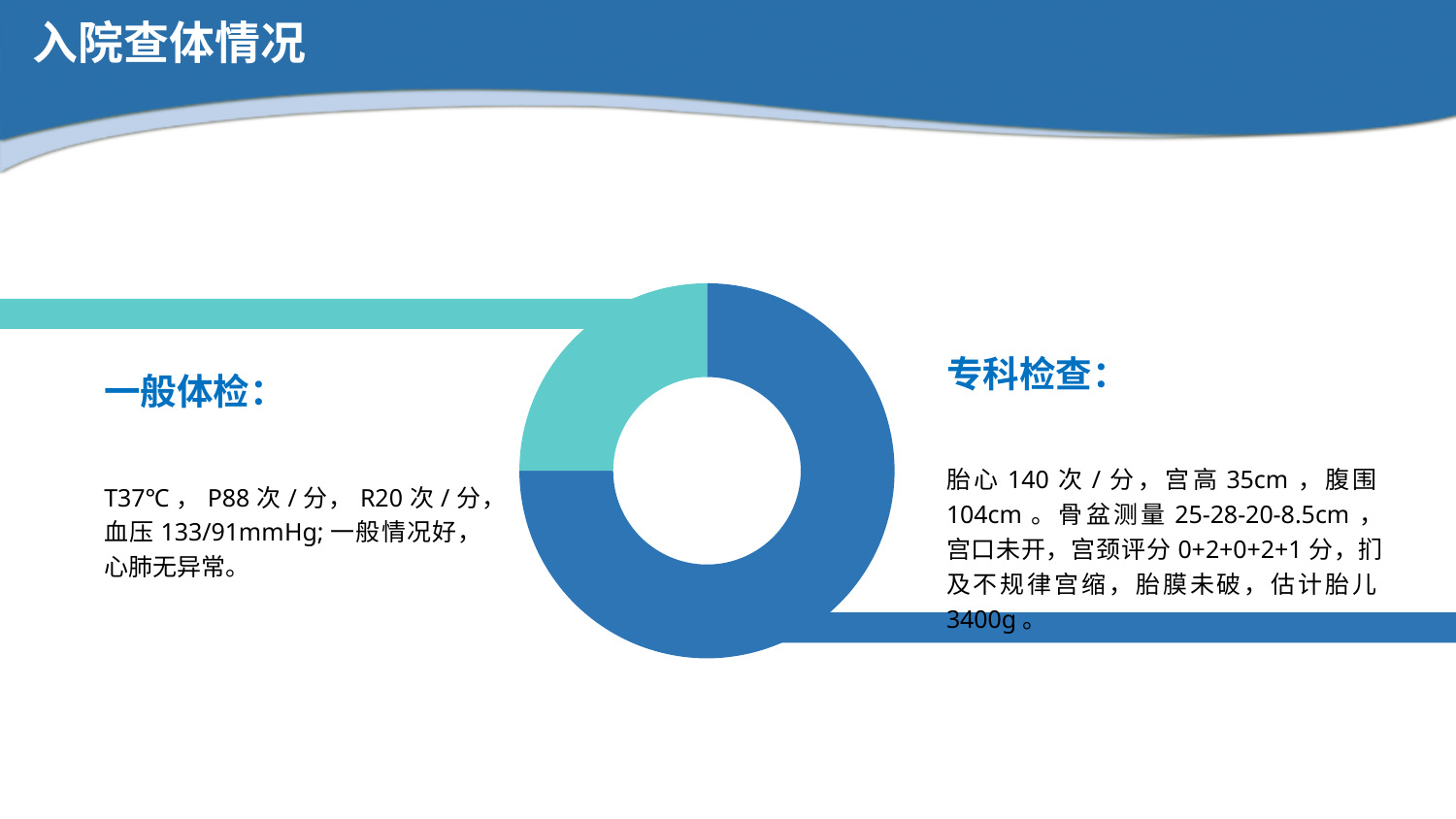
How many slices does the donut chart in the centre of the slide have? 2 Does the donut chart in the centre of the slide show a legend? No What kind of chart is shown in the centre of the slide? Pie (donut) chart In the donut chart in the centre of the slide, which slice is larger, the blue one or the teal one? The blue one In the donut chart in the centre of the slide, which slice is smaller, the blue one or the teal one? The teal one What two colours are used for the slices of the donut chart in the centre of the slide? Blue and teal